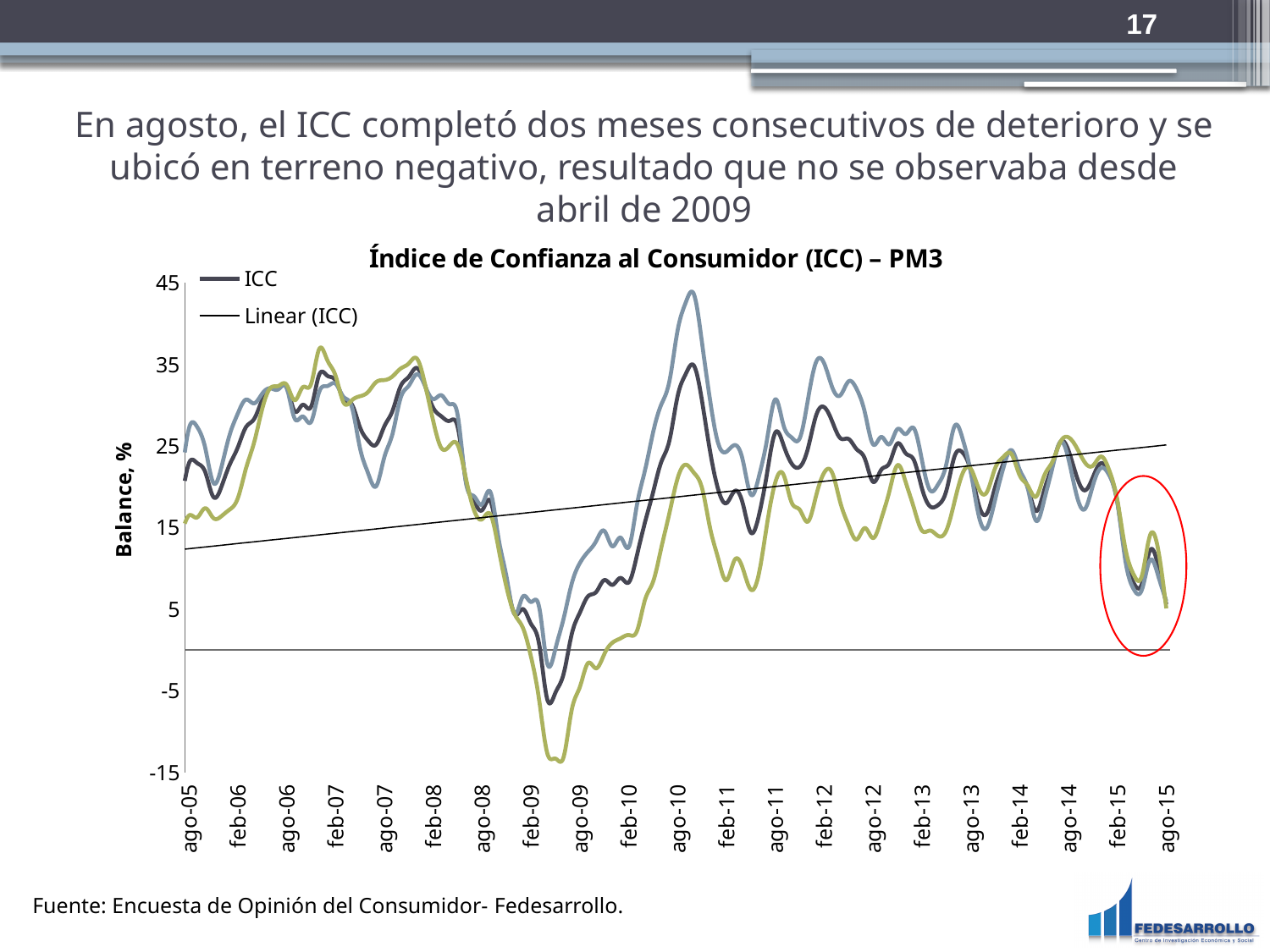
How many series does the chart legend list? 2 What is the title of the chart? Índice de Confianza al Consumidor (ICC) – PM3 Is the ICC value at ago-15 greater or less than 15? less Is the ICC value at ago-10 greater or less than 25? greater Is the lowest ICC value in 2009 greater or less than 0? less What is the label of the vertical axis? Balance, % Which is larger, the ICC value at ago-10 or the ICC value at ago-15? ago-10 In which year does the ICC line reach its lowest value? 2009 What kind of chart is shown on the slide? Line chart How many date labels are shown along the x axis? 21 Does the Linear (ICC) trend line rise or fall from left to right? Rises